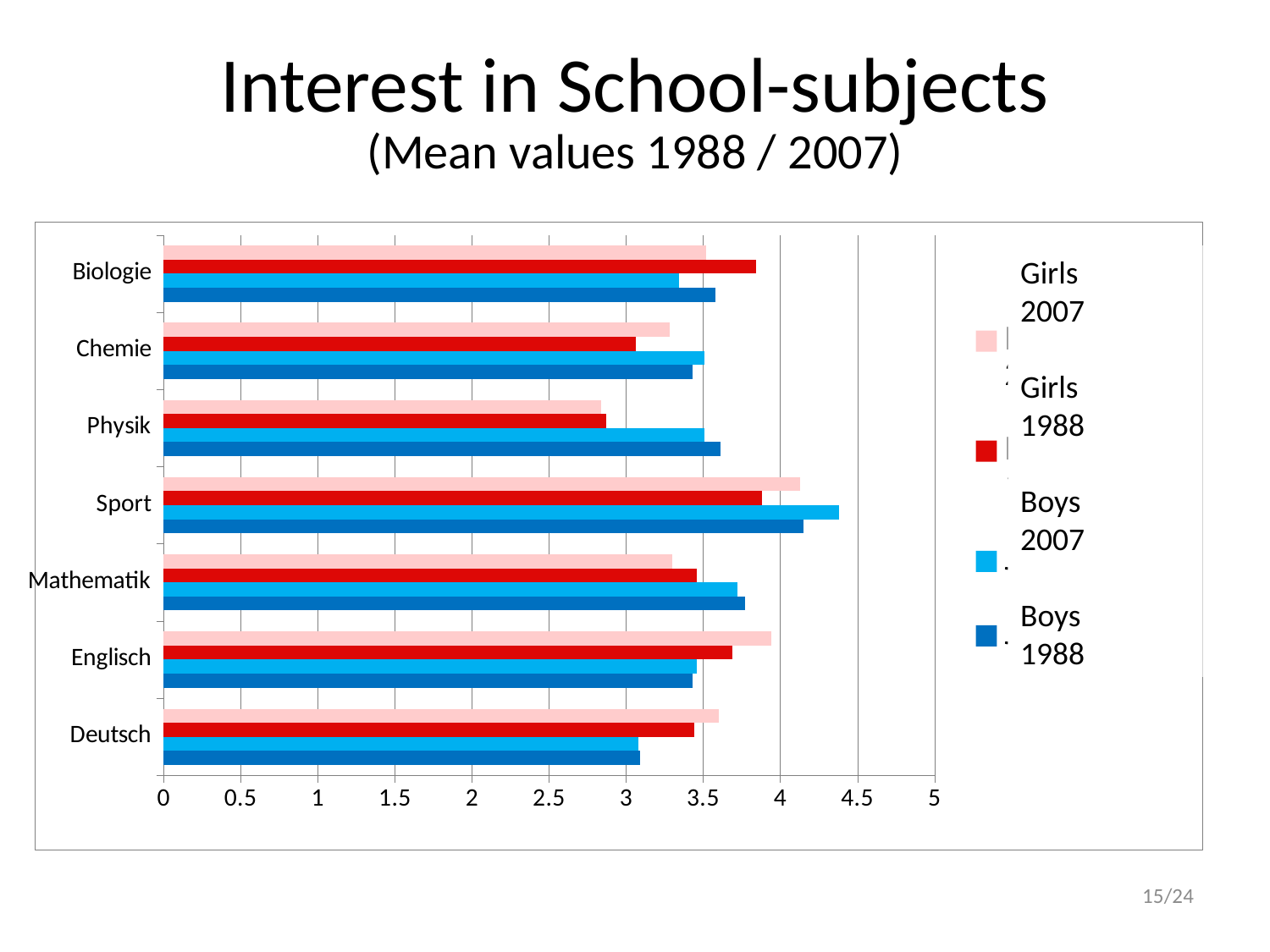
How many school subjects are listed on the chart? 7 Is the value for Girls 1988 in Biologie greater or less than 3.5? greater Which subject has the lowest value for Girls 2007? Physik What kind of chart is shown on the slide? bar chart Which subject has the highest value for Boys 2007? Sport Is the value for Boys 2007 in Sport greater or less than 4? greater Which subject has the longest bar overall on the chart? Sport How many series does the legend list? 4 What is the title of the slide? Interest in School-subjects (Mean values 1988 / 2007) In Sport, which is larger: the value for Boys 2007 or Girls 2007? Boys 2007 Is the value for Girls 2007 in Physik greater or less than 3? less In Physik, which is larger: the value for Boys 1988 or Girls 1988? Boys 1988